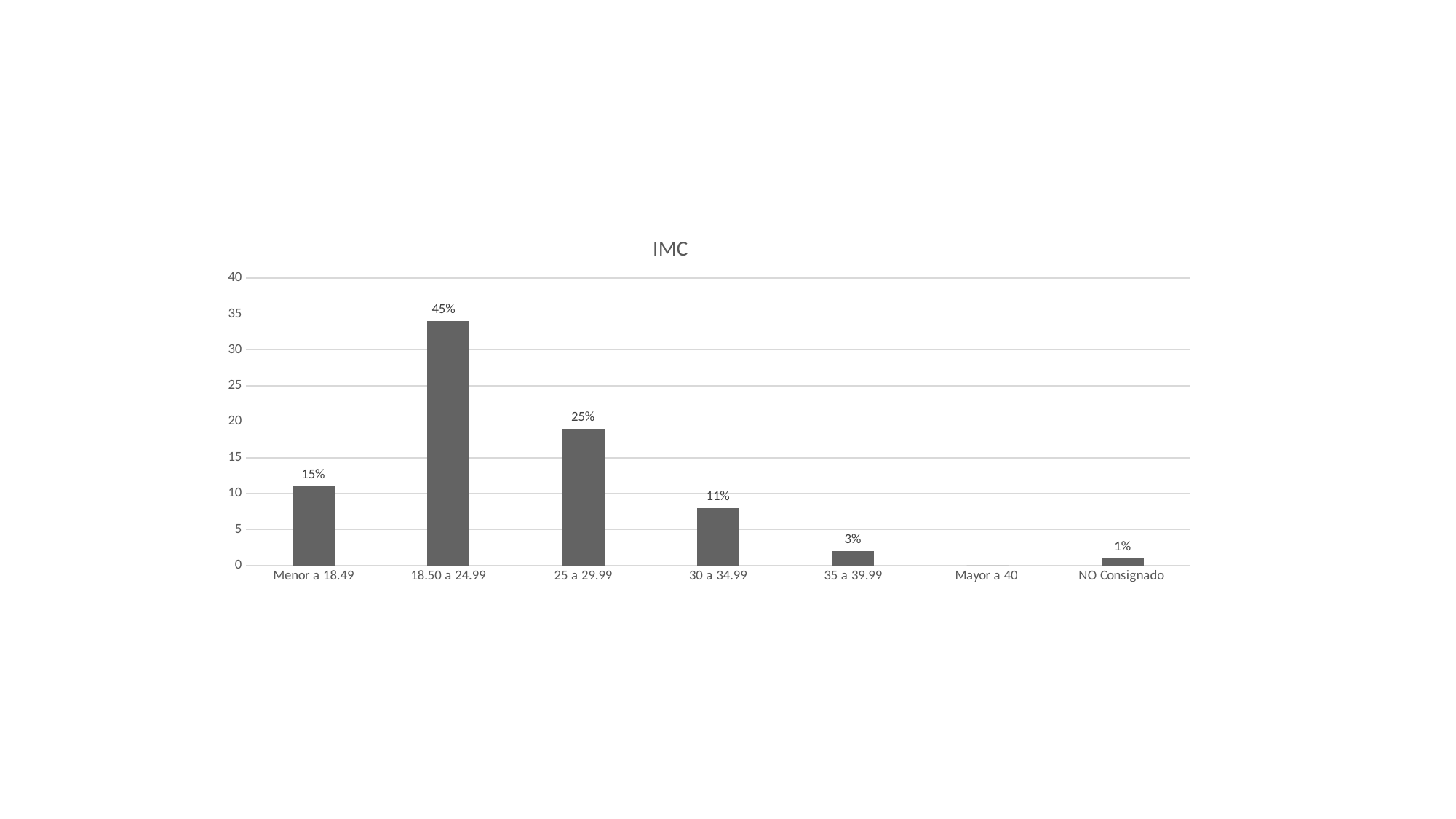
What is the data label shown for the category 18.50 a 24.99? 45% What is the data label shown for the category Menor a 18.49? 15% Which category has the lowest labelled value? NO Consignado What is the title of the chart? IMC What kind of chart is shown on the slide? bar chart Which is larger, the value for 25 a 29.99 or the value for 30 a 34.99? 25 a 29.99 What is the difference in percentage points between the labels for 18.50 a 24.99 and 25 a 29.99? 20 Is the bar for 18.50 a 24.99 greater or less than 30 on the vertical axis? greater Which category has the highest bar? 18.50 a 24.99 How many categories are shown on the x axis? 7 What is the data label shown for the category 30 a 34.99? 11% What is the data label shown for the category NO Consignado? 1%